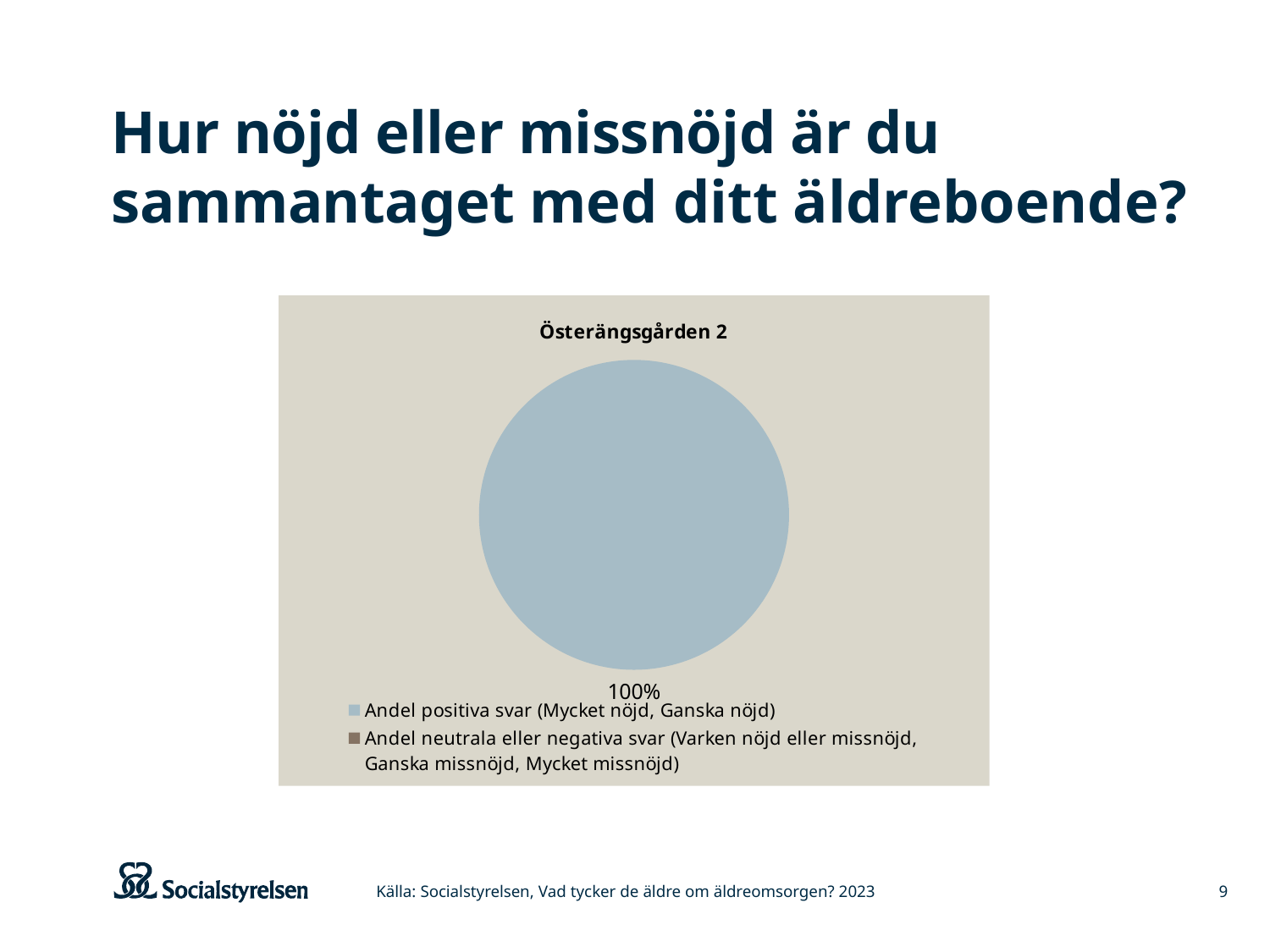
Which legend category does the slice labelled 100% belong to? Andel positiva svar (Mycket nöjd, Ganska nöjd) What colour is the slice representing Andel positiva svar? light blue What kind of chart is shown on the slide? pie chart Which category has the largest share of the pie? Andel positiva svar (Mycket nöjd, Ganska nöjd) What is the title of the chart? Österängsgården 2 Is the value for Andel positiva svar greater or less than 50%? greater How many slices are visible in the pie? 1 What share of the pie does the positive-answer slice take up? 100% What percentage is shown for Andel positiva svar (Mycket nöjd, Ganska nöjd)? 100% How many entries does the legend list? 2